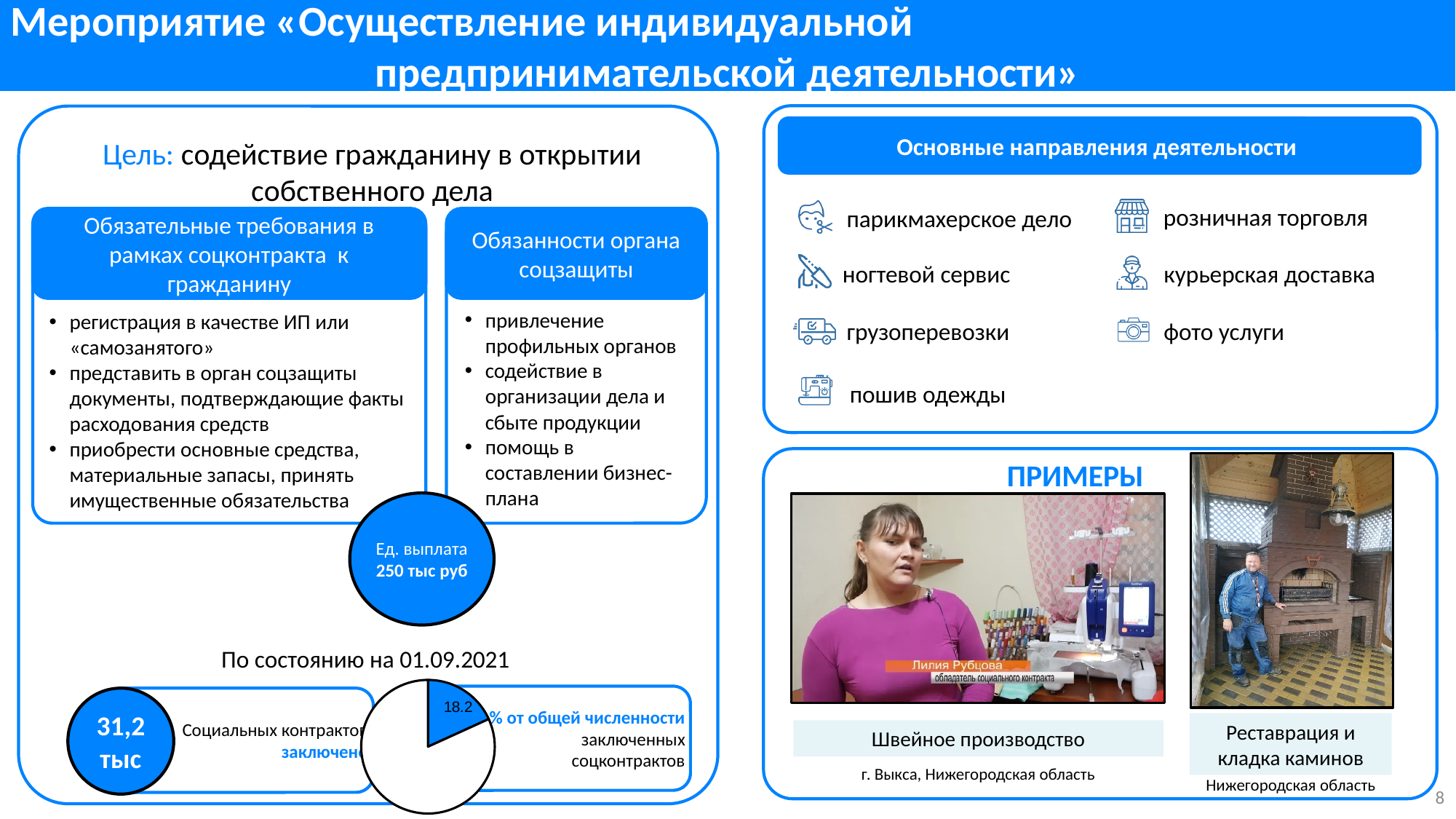
In the pie chart at the bottom of the left panel, what colour is the slice labelled 18.2? blue What date is stated above the pie chart at the bottom of the left panel? 01.09.2021 In the pie chart at the bottom of the left panel, is the blue slice larger or smaller than the white slice? smaller What kind of chart is shown at the bottom of the left panel, next to the text 'По состоянию на 01.09.2021'? pie chart In the pie chart at the bottom of the left panel, is the blue slice greater or less than half of the pie? less In the pie chart at the bottom of the left panel, what value is printed on the blue slice? 18.2 How many slices does the pie chart at the bottom of the left panel have? 2